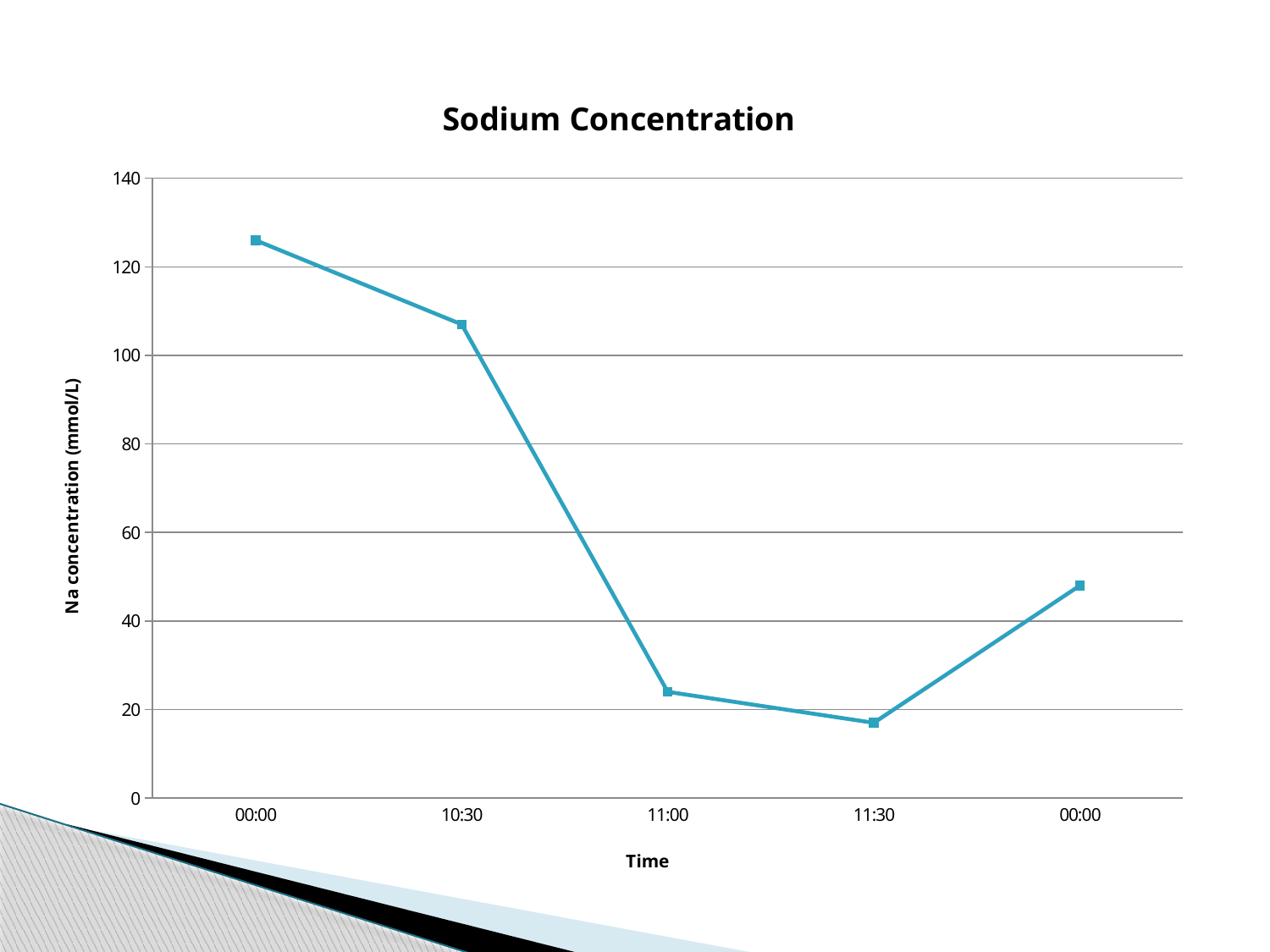
At which time is the sodium concentration highest? 00:00 (the first point) Is the value at 10:30 greater or less than 100? greater What is the label of the vertical axis? Na concentration (mmol/L) Is the value at 11:30 greater or less than 20? less Which is larger, the value at 10:30 or the value at 11:00? 10:30 Is the value at 11:00 greater or less than 40? less What type of chart is shown on the slide? Line chart How does the sodium concentration change from the first 00:00 point to 11:30? It falls At which time is the sodium concentration lowest? 11:30 How many data points are plotted on the line? 5 What is the title of the chart? Sodium Concentration